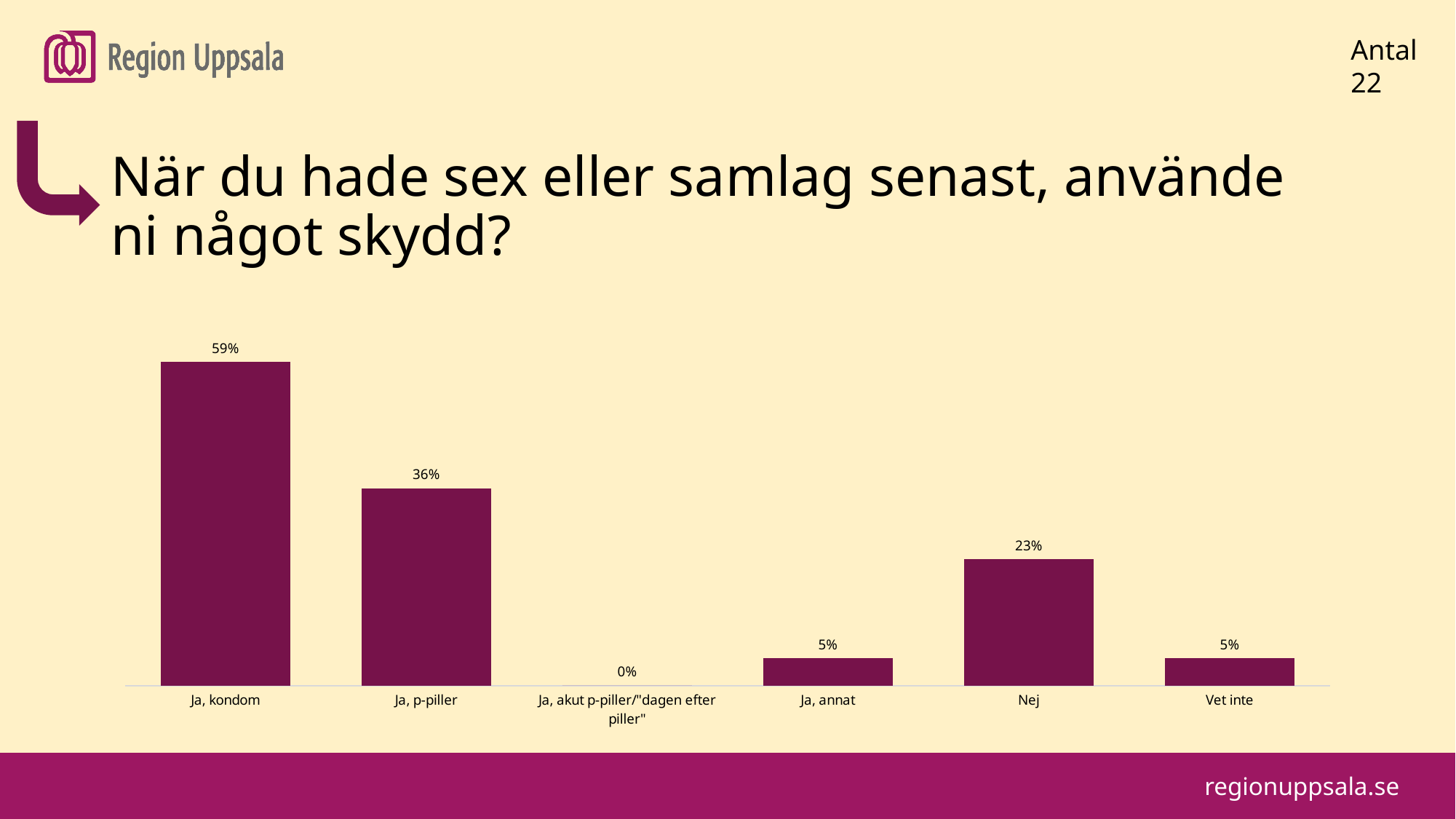
What is the value for "Ja, kondom"? 59% What kind of chart is shown on the slide? Bar chart What is the value for "Nej"? 23% What is the difference between the values for "Ja, kondom" and "Ja, p-piller"? 23% Which is larger, the value for "Ja, p-piller" or the value for "Nej"? Ja, p-piller What number is shown next to "Antal" in the top right corner of the slide? 22 What is the value for "Ja, akut p-piller/"dagen efter piller""? 0% What is the difference between the values for "Nej" and "Ja, annat"? 18% Which category has the lowest value? Ja, akut p-piller/"dagen efter piller" How many categories are shown on the x axis? 6 What is the value for "Ja, p-piller"? 36% Which category has the highest value? Ja, kondom